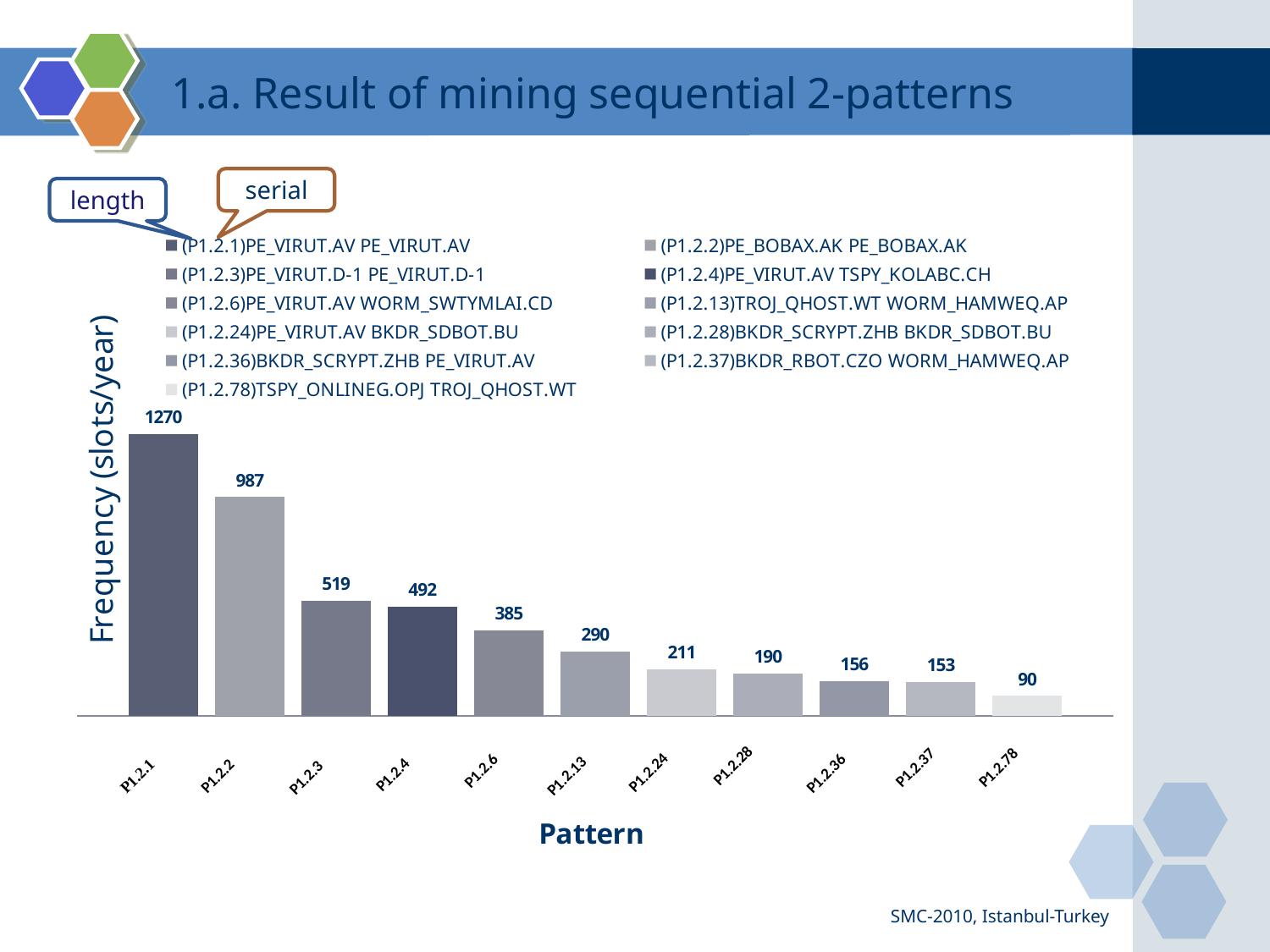
How many entries does the chart legend list? 11 What is the frequency value for pattern P1.2.36? 156 What is the difference in frequency between P1.2.1 and P1.2.2? 283 What is the frequency value for pattern P1.2.1? 1270 Which has a higher frequency, P1.2.6 or P1.2.24? P1.2.6 Do the frequency values rise or fall moving left to right along the x axis? fall Which pattern has the highest frequency? P1.2.1 Which pattern has the lowest frequency? P1.2.78 How many patterns are shown on the x axis of the chart? 11 What is the frequency value for pattern P1.2.13? 290 What type of chart is shown on the slide? bar chart What is the difference in frequency between P1.2.3 and P1.2.4? 27